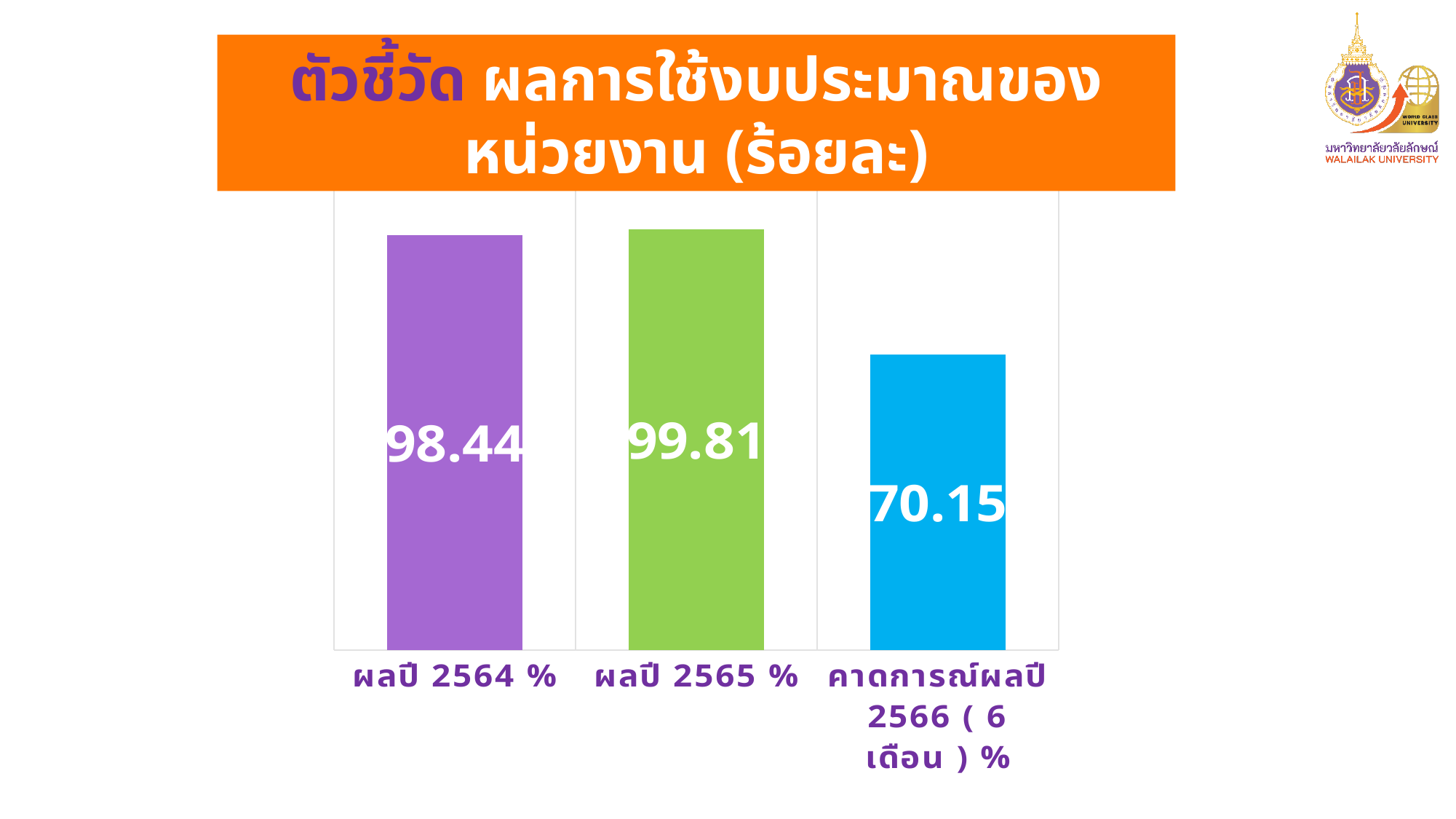
Which category has the lowest value? คาดการณ์ผลปี 2566 ( 6 เดือน ) % How many categories are shown in the chart? 3 What is the value for คาดการณ์ผลปี 2566 ( 6 เดือน ) %? 70.15 What is the difference between the values for ผลปี 2565 % and ผลปี 2564 %? 1.37 What kind of chart is shown on the slide? Bar chart What colour is the bar for ผลปี 2565 %? Green What is the value for ผลปี 2565 %? 99.81 Which category has the highest value? ผลปี 2565 % What is the title of the slide? ตัวชี้วัด ผลการใช้งบประมาณของหน่วยงาน (ร้อยละ) What is the difference between the values for ผลปี 2565 % and คาดการณ์ผลปี 2566 ( 6 เดือน ) %? 29.66 Which is larger, the value for ผลปี 2564 % or the value for คาดการณ์ผลปี 2566 ( 6 เดือน ) %? ผลปี 2564 % What is the value for ผลปี 2564 %? 98.44